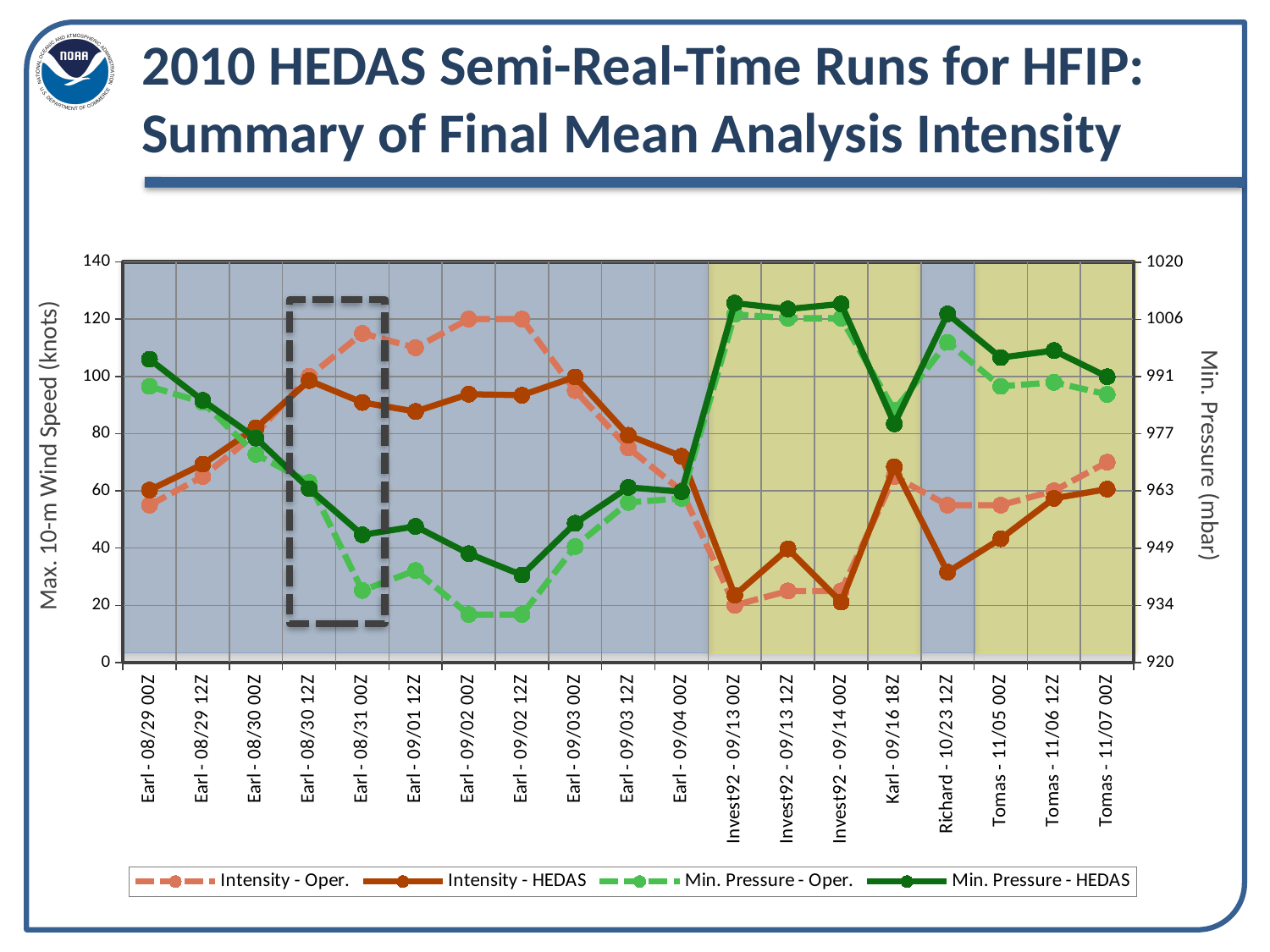
What is the label of the right-hand y axis? Min. Pressure (mbar) Is the Intensity - HEDAS value for Karl - 09/16 18Z greater or less than 60? greater Is the Intensity - Oper. value for Tomas - 11/07 00Z greater or less than 60? greater Is the Intensity - HEDAS value for Invest92 - 09/13 00Z greater or less than 40? less At Invest92 - 09/13 12Z, which is larger: Intensity - Oper. or Intensity - HEDAS? Intensity - HEDAS Does the Intensity - HEDAS series rise or fall across the three Tomas runs? rise At Earl - 08/31 00Z, which is larger: Intensity - Oper. or Intensity - HEDAS? Intensity - Oper. Does the Intensity - Oper. series rise or fall from Earl - 09/02 12Z to Earl - 09/04 00Z? fall How many series does the legend list? 4 How many storm run dates are shown along the x axis? 19 What kind of chart is shown on the slide? line chart